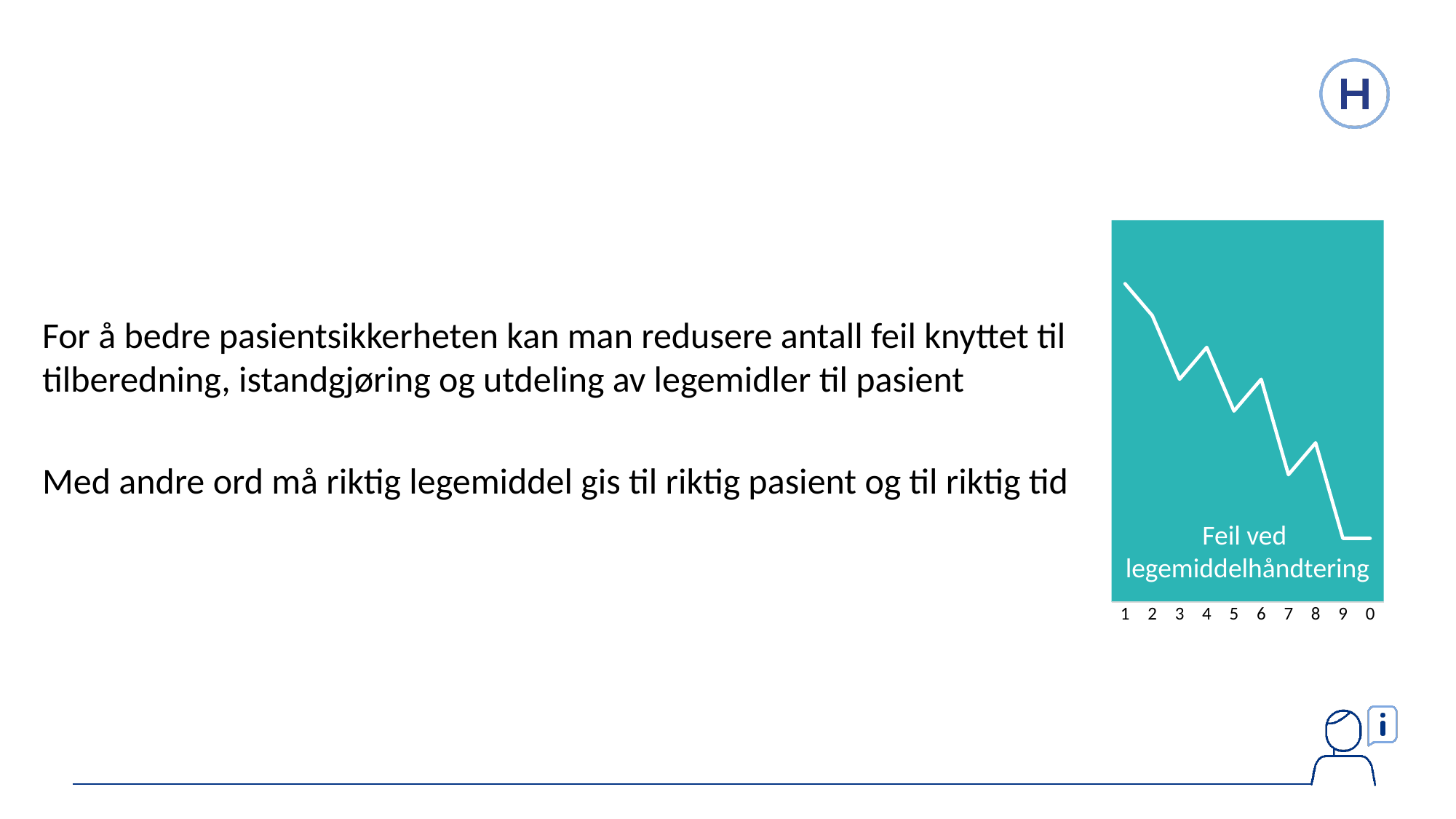
What colour is the background of the chart area? teal What kind of chart is shown on the slide? line chart Which is larger in the chart, the value at 4 or the value at 5? 4 Which is larger in the chart, the value at 8 or the value at 9? 8 Which is larger in the chart, the value at 6 or the value at 7? 6 Do the values in the chart generally rise or fall along the x axis? fall How many points are plotted along the x axis of the chart? 10 What is the title of the chart on the slide? Feil ved legemiddelhåndtering Which x-axis category has the highest value in the chart? 1